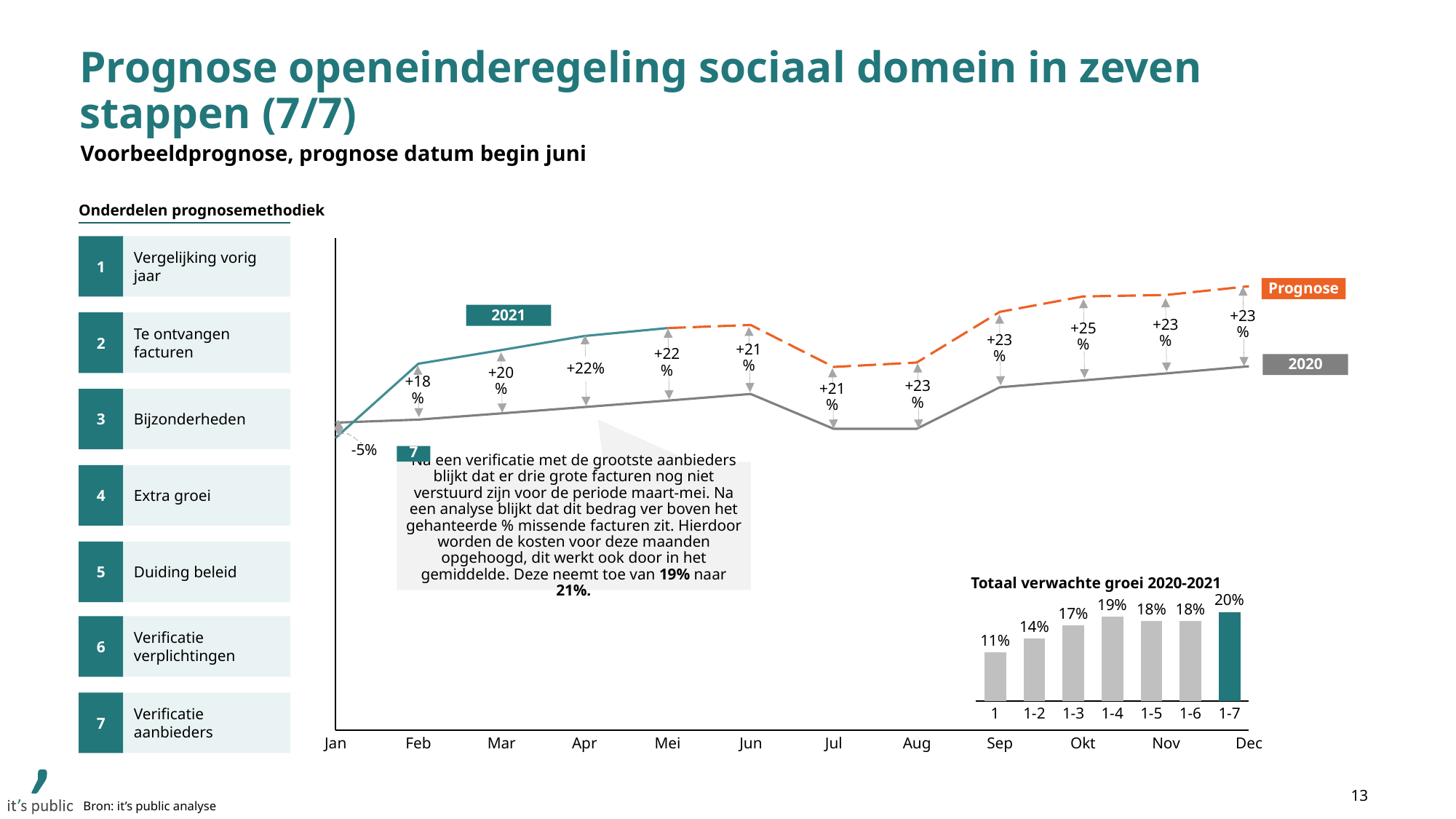
In the bar chart titled 'Totaal verwachte groei 2020-2021', which category has the lowest value? 1 What kind of chart is the small chart titled 'Totaal verwachte groei 2020-2021'? bar chart In the bar chart titled 'Totaal verwachte groei 2020-2021', what is the value for category 1? 11% In the large line chart, which line is drawn as an orange dashed line? Prognose In the large line chart, what percentage difference is labelled for Jan? -5% In the bar chart titled 'Totaal verwachte groei 2020-2021', how many bars are shown? 7 In the bar chart titled 'Totaal verwachte groei 2020-2021', what is the difference between the values for 1-7 and 1? 9% In the large line chart, what percentage difference is labelled for Okt? +25% In the large line chart, how many months are shown on the x axis? 12 In the bar chart titled 'Totaal verwachte groei 2020-2021', what is the value for category 1-7? 20% In the bar chart titled 'Totaal verwachte groei 2020-2021', which category has the highest value? 1-7 In the bar chart titled 'Totaal verwachte groei 2020-2021', what is the value for category 1-4? 19%